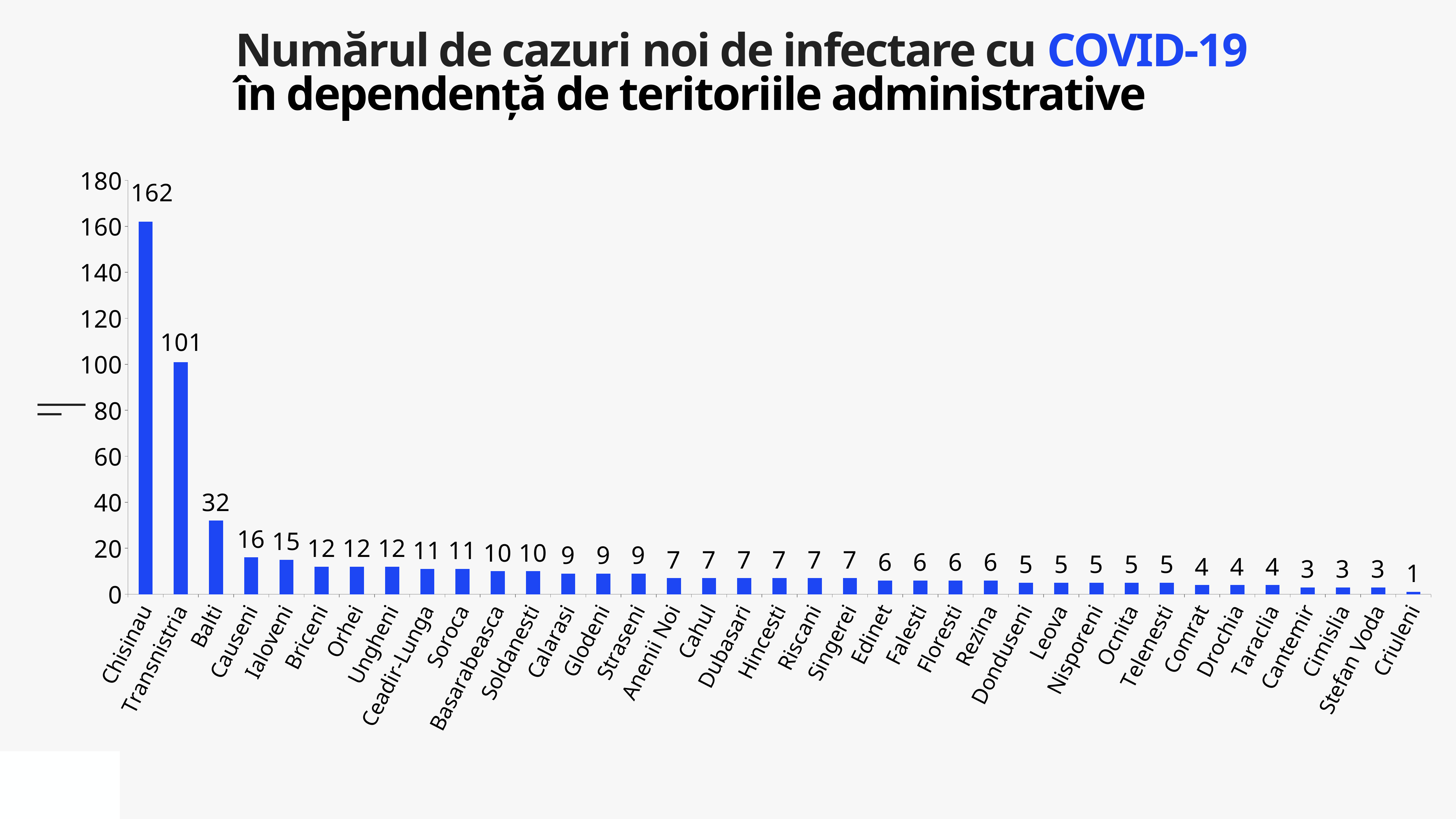
What is the value for Transnistria? 101 Is the value for Transnistria greater or less than 80? greater Which territory has the highest number of new cases? Chisinau Do the values rise or fall from left to right along the x axis? fall What is the value for Causeni? 16 Which territory has the lowest number of new cases? Criuleni What kind of chart is shown on the slide? bar chart What is the value for Chisinau? 162 What is the difference between the values for Chisinau and Transnistria? 61 How many territories are shown on the chart? 37 What is the value for Balti? 32 Which is larger, the value for Balti or the value for Causeni? Balti